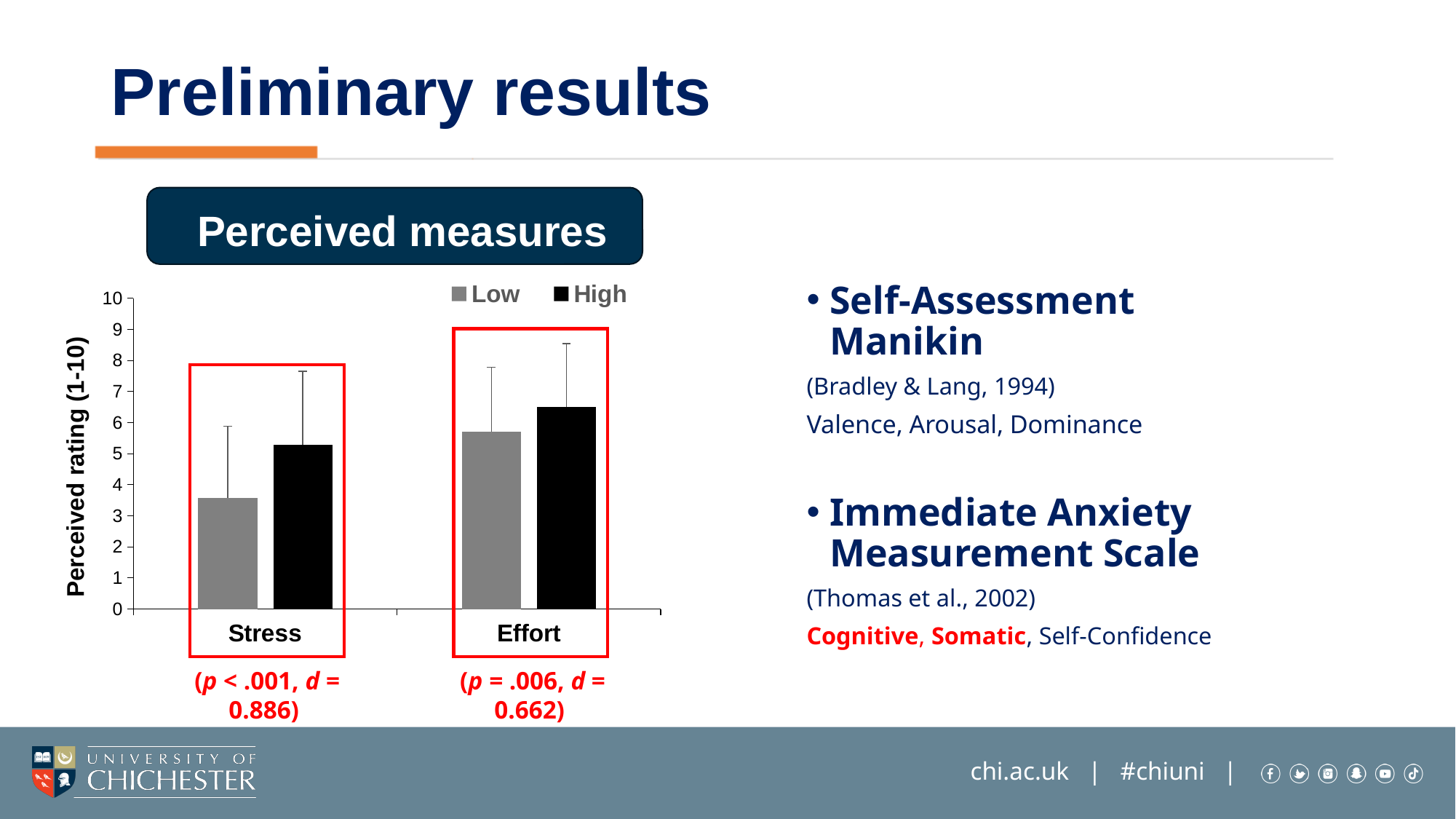
Is the value of the Low bar for Effort greater or less than 5? greater Which bar in the chart is the lowest? Low for Stress How many categories are shown on the x axis of the chart? 2 What is the label of the chart's y axis? Perceived rating (1-10) Is the value of the High bar for Effort greater or less than 7? less How many series does the chart's legend list? 2 Is the value of the High bar for Stress greater or less than 4? greater What kind of chart is shown on the slide? Bar chart For Effort, which is larger, the Low or the High bar? High Which bar in the chart is the highest? High for Effort For Stress, which is larger, the Low or the High bar? High